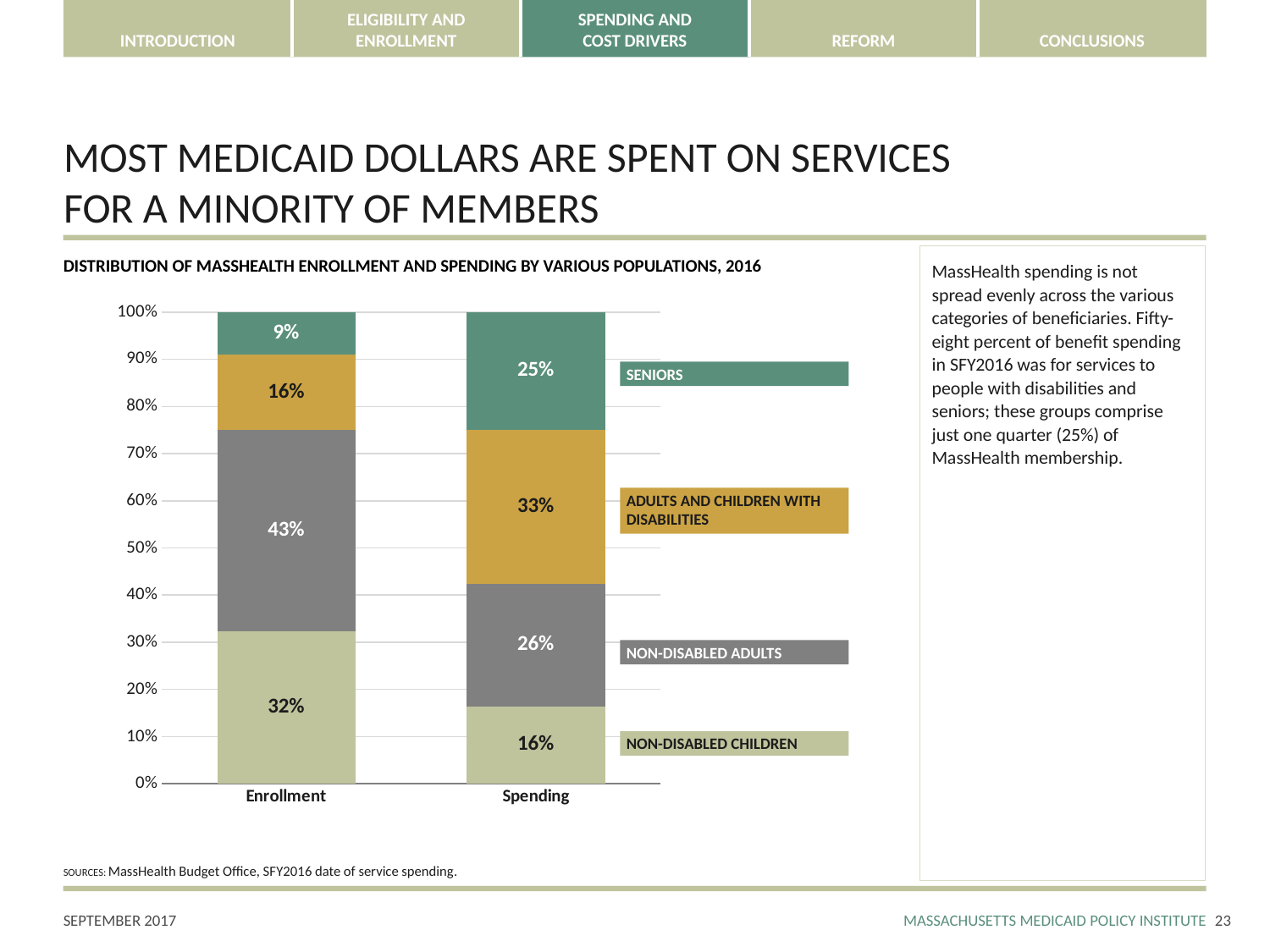
What share of Enrollment is Non-Disabled Children? 32% Is the Seniors share larger in Enrollment or in Spending? Spending Which population has the largest share of Enrollment? Non-Disabled Adults What type of chart is shown? Stacked bar chart Which population has the largest share of Spending? Adults and Children with Disabilities What share of Spending is Adults and Children with Disabilities? 33% Which population has the smallest share of Enrollment? Seniors What share of Spending is Seniors? 25% What is the difference between the Non-Disabled Adults share of Enrollment and of Spending? 17 percentage points What is the combined share of Spending for Seniors and Adults and Children with Disabilities? 58% What share of Enrollment is Seniors? 9% How many populations does the legend list? 4